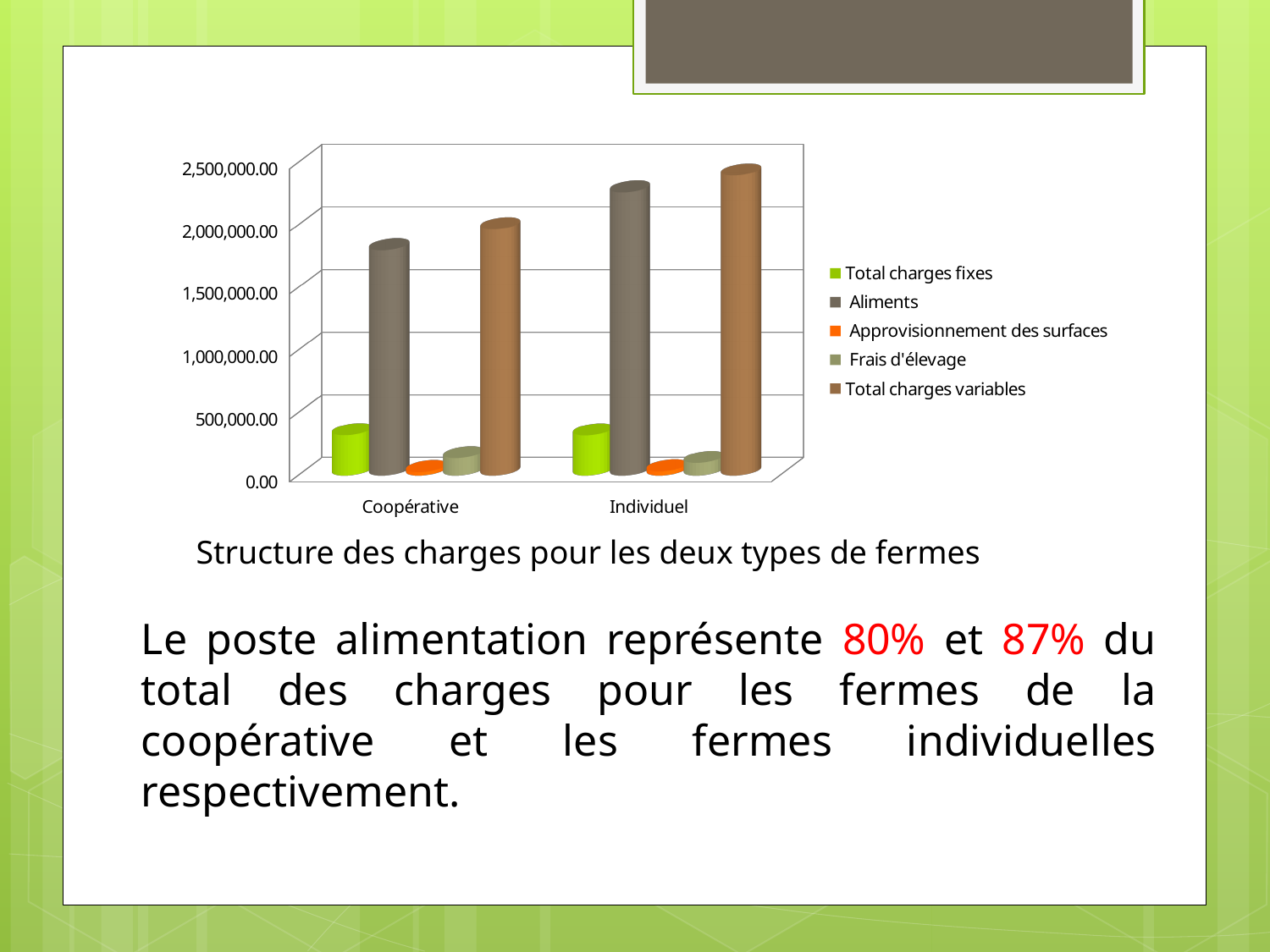
Is the Total charges variables value for Individuel greater or less than 2,000,000.00? greater Is the Total charges fixes value for Coopérative greater or less than 500,000.00? less Which series is shown in bright green in the legend? Total charges fixes Which category has the tallest bar for Aliments? Individuel Which series has the lowest values in both categories? Approvisionnement des surfaces What kind of chart is shown on the slide? bar chart Does the Total charges variables value rise or fall from Coopérative to Individuel? rise Is the Aliments value for Coopérative greater or less than 1,500,000.00? greater How many series does the chart legend list? 5 Is the Aliments value for Individuel larger or smaller than the Aliments value for Coopérative? larger How many categories are shown on the x axis of the chart? 2 What is the caption written below the chart? Structure des charges pour les deux types de fermes